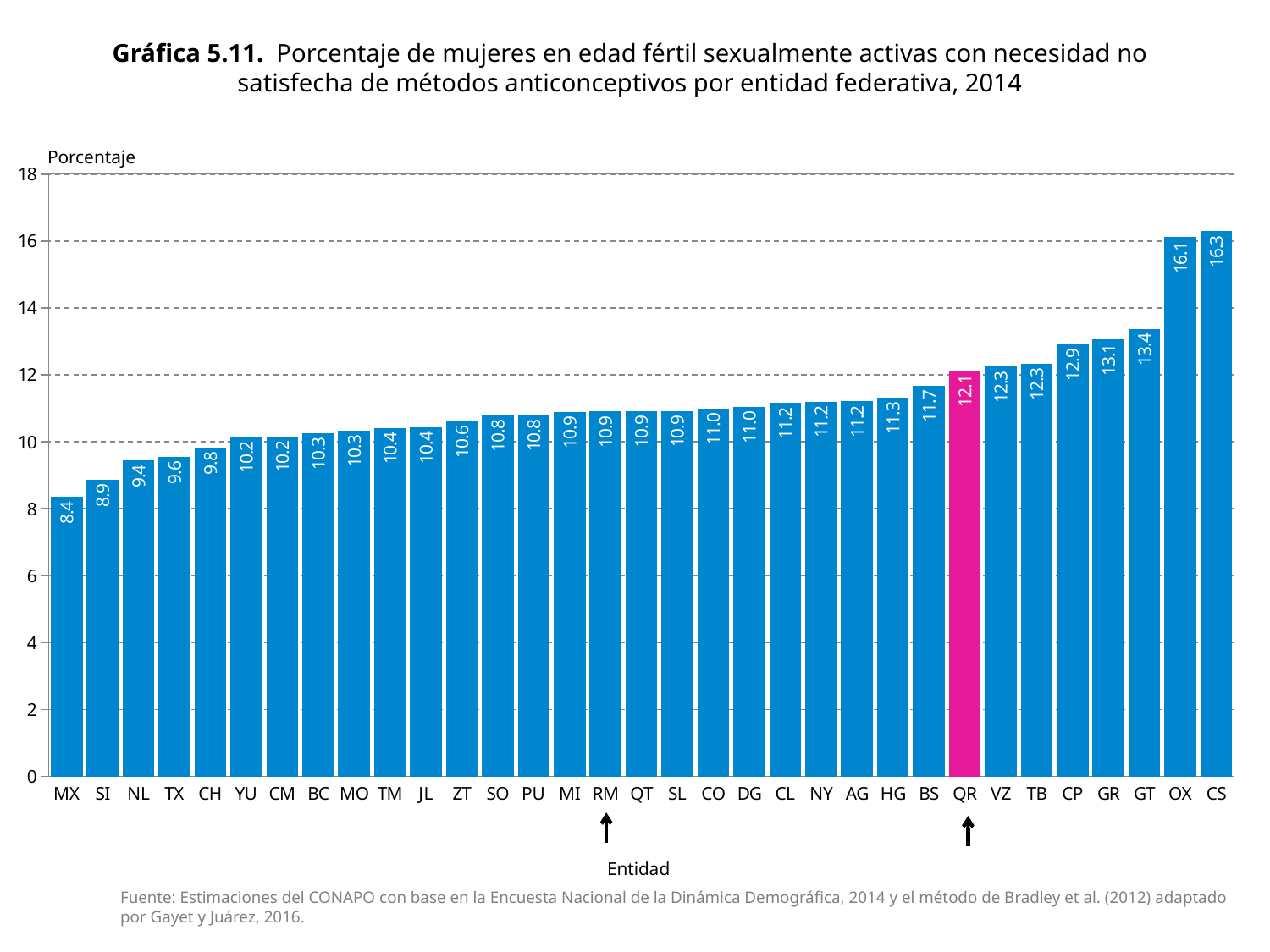
How many entities are shown on the x axis? 33 Which entity has the lowest value? MX What is the value for OX? 16.1 What is the difference between the values for CS and MX? 7.9 What is the difference between the values for QR and RM? 1.2 Which bar is highlighted in a different colour (pink) from the others? QR Is the value for BS greater or less than 12? less What is the value for QR? 12.1 What kind of chart is this? bar chart What is the value for RM? 10.9 Which entity has the highest value? CS Which is larger, the value for GT or the value for CP? GT